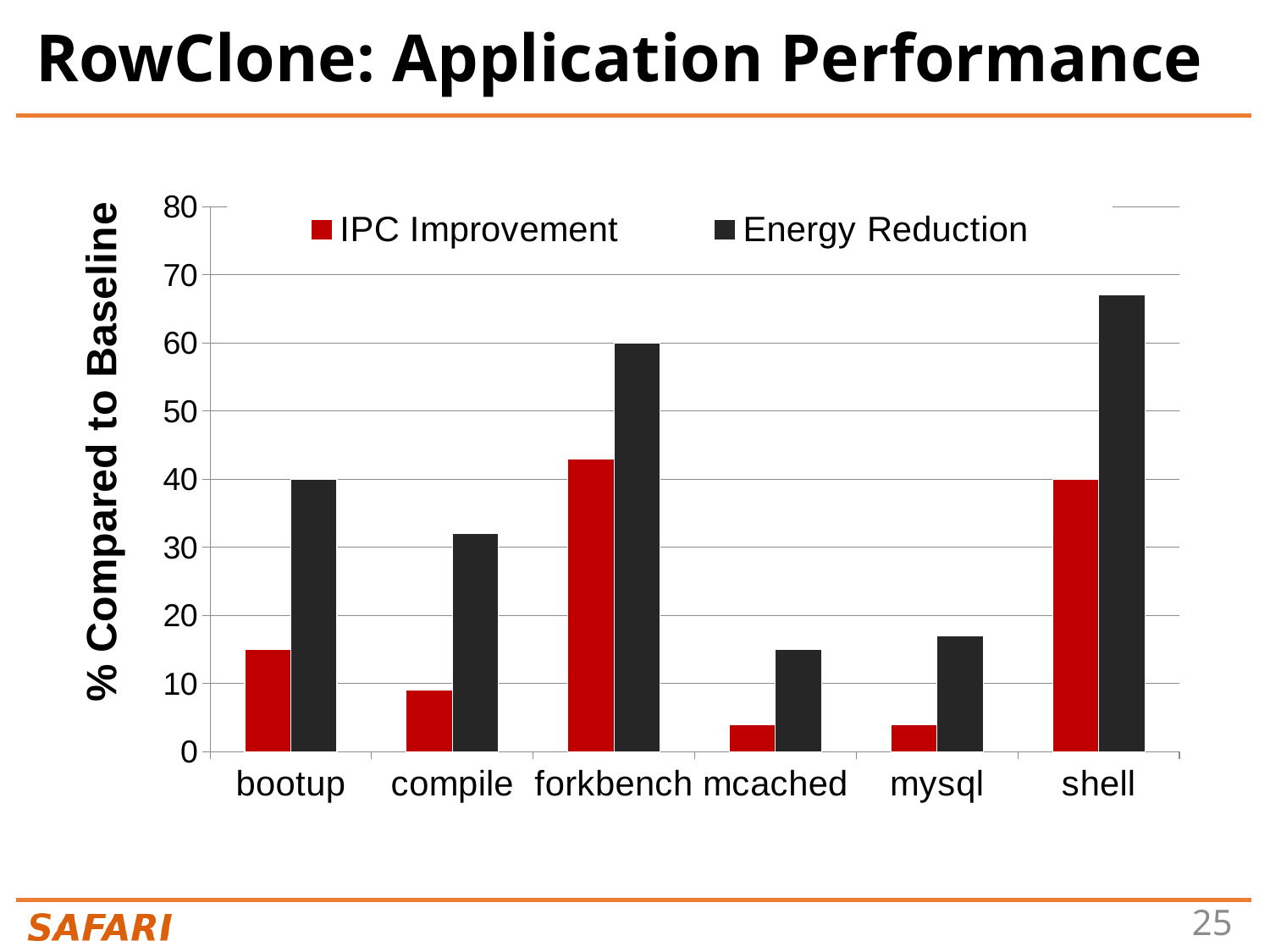
How many series does the legend list? 2 Which application has the highest IPC Improvement? forkbench How many applications are shown on the x axis? 6 Which application has the highest Energy Reduction? shell Is the IPC Improvement for mcached greater or less than 10? less What type of chart is shown on the slide? bar chart What is the Energy Reduction value for bootup? 40 Which is larger, the Energy Reduction for bootup or the Energy Reduction for compile? bootup What is the IPC Improvement value for shell? 40 What is the Energy Reduction value for forkbench? 60 What is the title of the y axis? % Compared to Baseline Is the Energy Reduction for compile greater or less than 30? greater